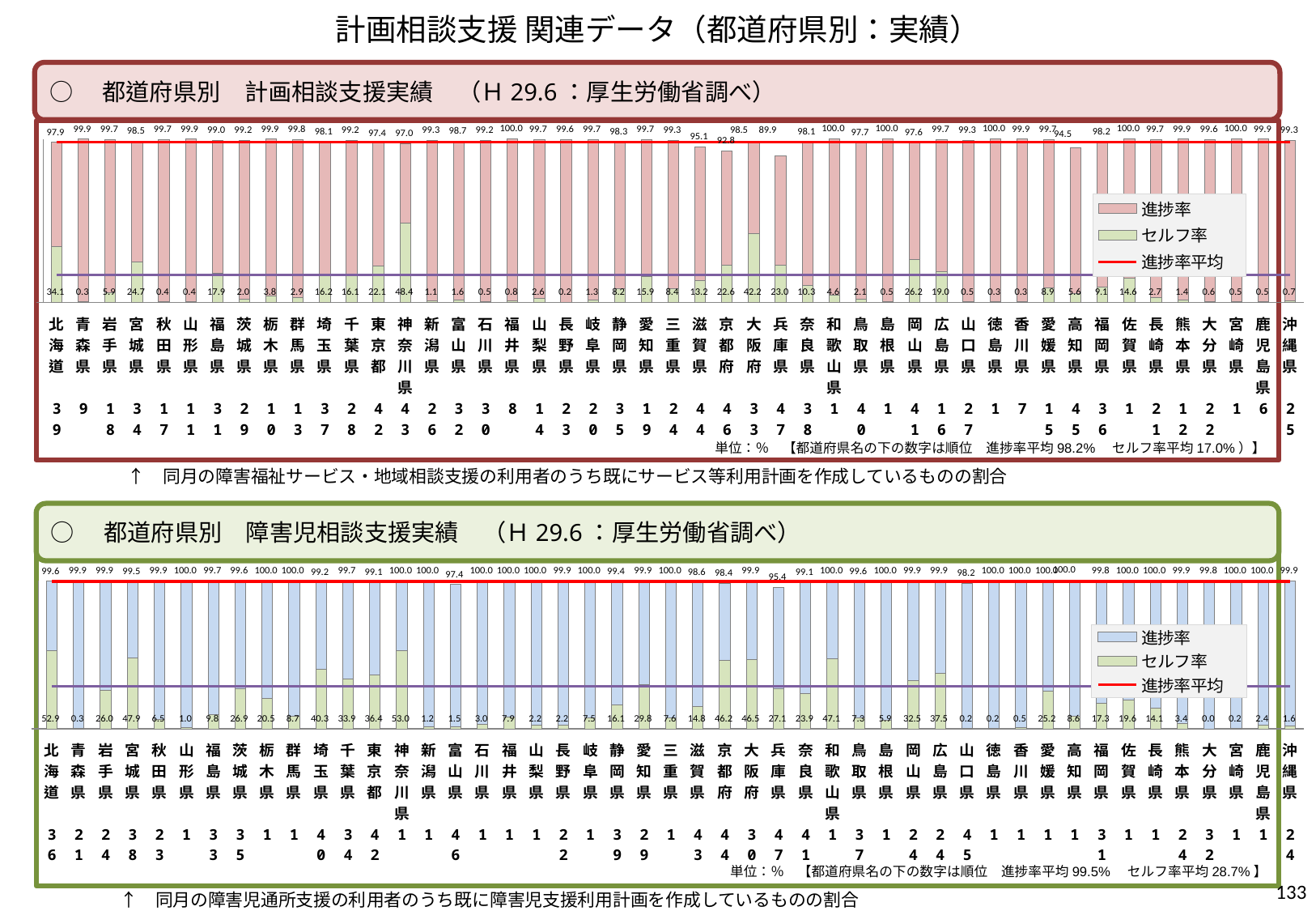
In the top chart (都道府県別 計画相談支援実績), what is the 進捗率 for 兵庫県? 89.9 In the bottom chart (都道府県別 障害児相談支援実績), which prefecture has the lowest 進捗率? 兵庫県 How many prefectures are plotted in the bottom chart (都道府県別 障害児相談支援実績)? 47 In the top chart (都道府県別 計画相談支援実績), which prefecture has the highest セルフ率? 神奈川県 In the bottom chart (都道府県別 障害児相談支援実績), what is the 進捗率 for 兵庫県? 95.4 In the top chart (都道府県別 計画相談支援実績), what is the セルフ率 for 神奈川県? 48.4 In the top chart (都道府県別 計画相談支援実績), which has the larger セルフ率, 北海道 or 宮城県? 北海道 How many entries does the legend of the top chart (都道府県別 計画相談支援実績) list? 3 In the top chart (都道府県別 計画相談支援実績), which prefecture has the lowest 進捗率? 兵庫県 In the bottom chart (都道府県別 障害児相談支援実績), what is the セルフ率 for 埼玉県? 40.3 What kind of chart is the bottom chart (都道府県別 障害児相談支援実績)? bar chart In the top chart (都道府県別 計画相談支援実績), what is the difference between the セルフ率 of 神奈川県 and 大阪府? 6.2